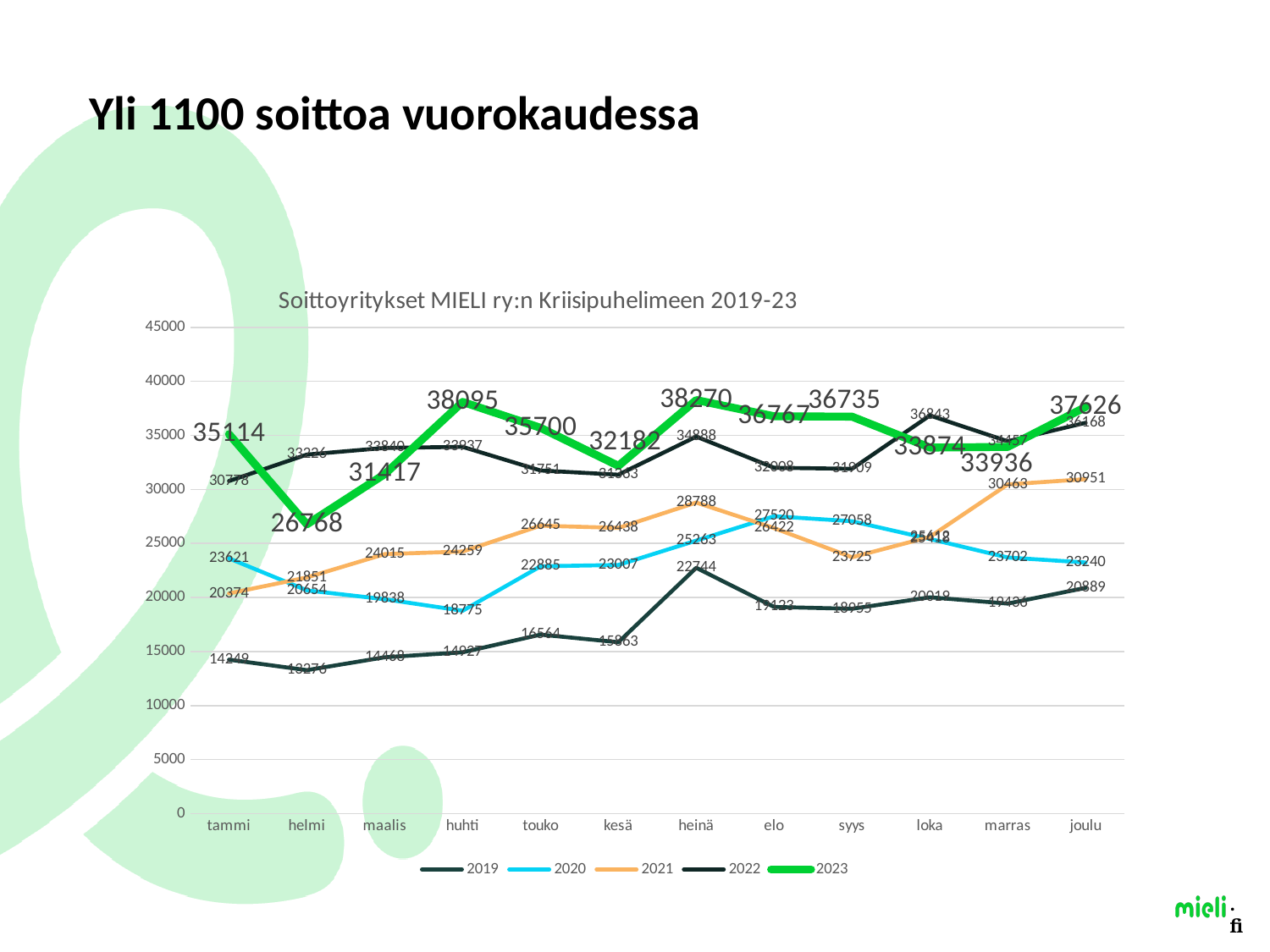
What is the value for 2023 in helmi? 26768 In which month is the 2023 series highest? heinä What is the value for 2023 in huhti? 38095 Which is larger for 2023: the value in huhti or the value in heinä? heinä What is the difference between the 2023 values for joulu and tammi? 2512 What is the title of the chart? Soittoyritykset MIELI ry:n Kriisipuhelimeen 2019-23 In which month is the 2023 series lowest? helmi Is the value for 2019 in helmi greater or less than 15000? less What kind of chart is shown on the slide? line chart How many series does the legend list? 5 What is the value for 2021 in heinä? 28788 How many months are shown on the x axis? 12